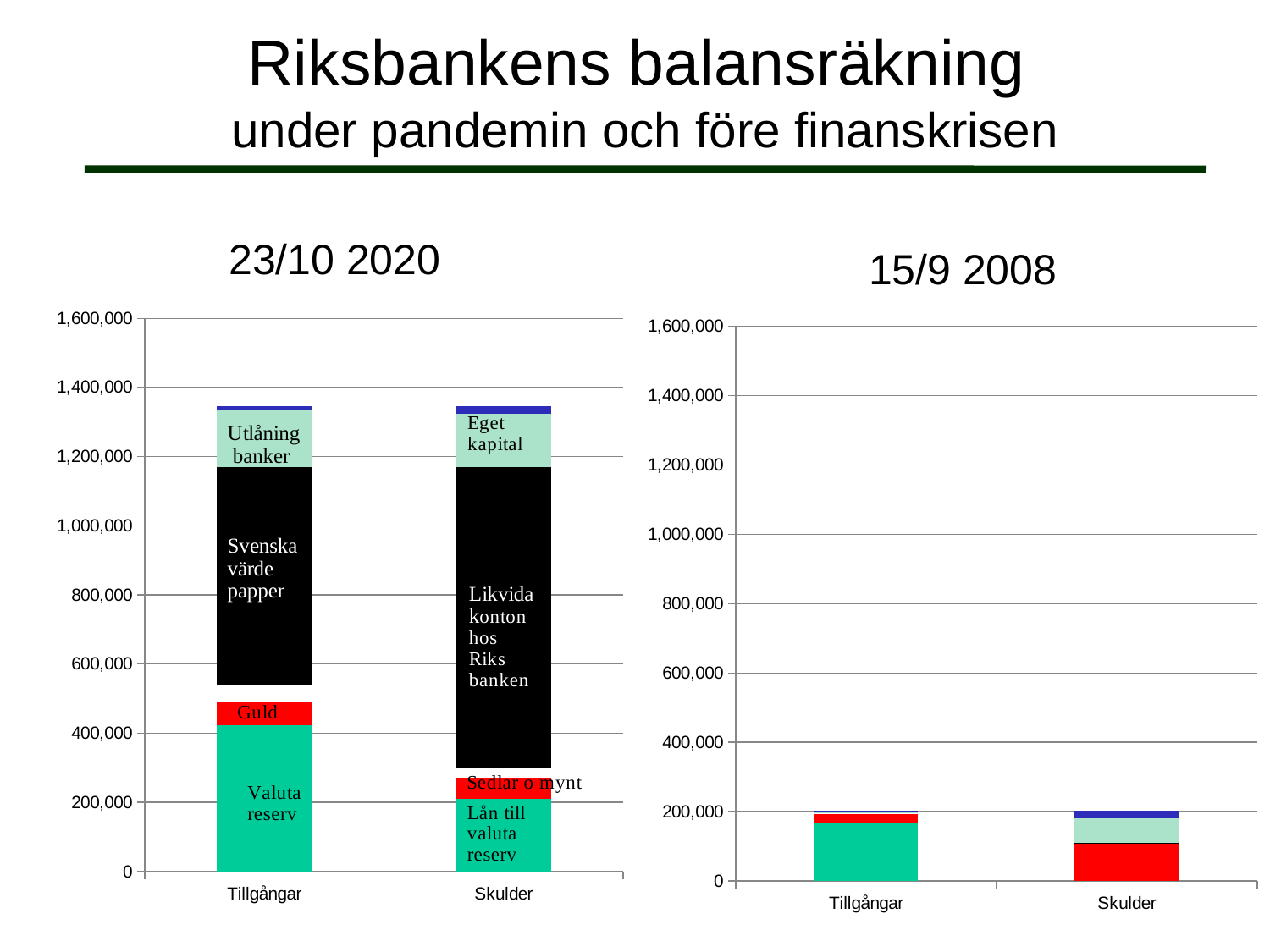
In the '23/10 2020' chart, which segment is at the bottom of the Tillgångar bar? Valuta reserv In the '23/10 2020' chart, is the Valuta reserv segment of the Tillgångar bar greater or less than 600,000? less What are the two categories on the x axis of the '23/10 2020' chart? Tillgångar and Skulder In the '23/10 2020' chart, which segment is the largest in the Tillgångar bar? Svenska värdepapper Which is larger: the Tillgångar bar in the '23/10 2020' chart or the Tillgångar bar in the '15/9 2008' chart? 23/10 2020 How many categories are shown on the x axis of the '15/9 2008' chart? 2 In the '15/9 2008' chart, is the total of the Skulder bar greater or less than 600,000? less In the '23/10 2020' chart, which segment is the largest in the Skulder bar? Likvida konton hos Riksbanken In the '15/9 2008' chart, is the total of the Tillgångar bar greater or less than 400,000? less What is the highest value shown on the y axis of the '15/9 2008' chart? 1,600,000 What kind of chart is the '23/10 2020' chart? stacked bar chart